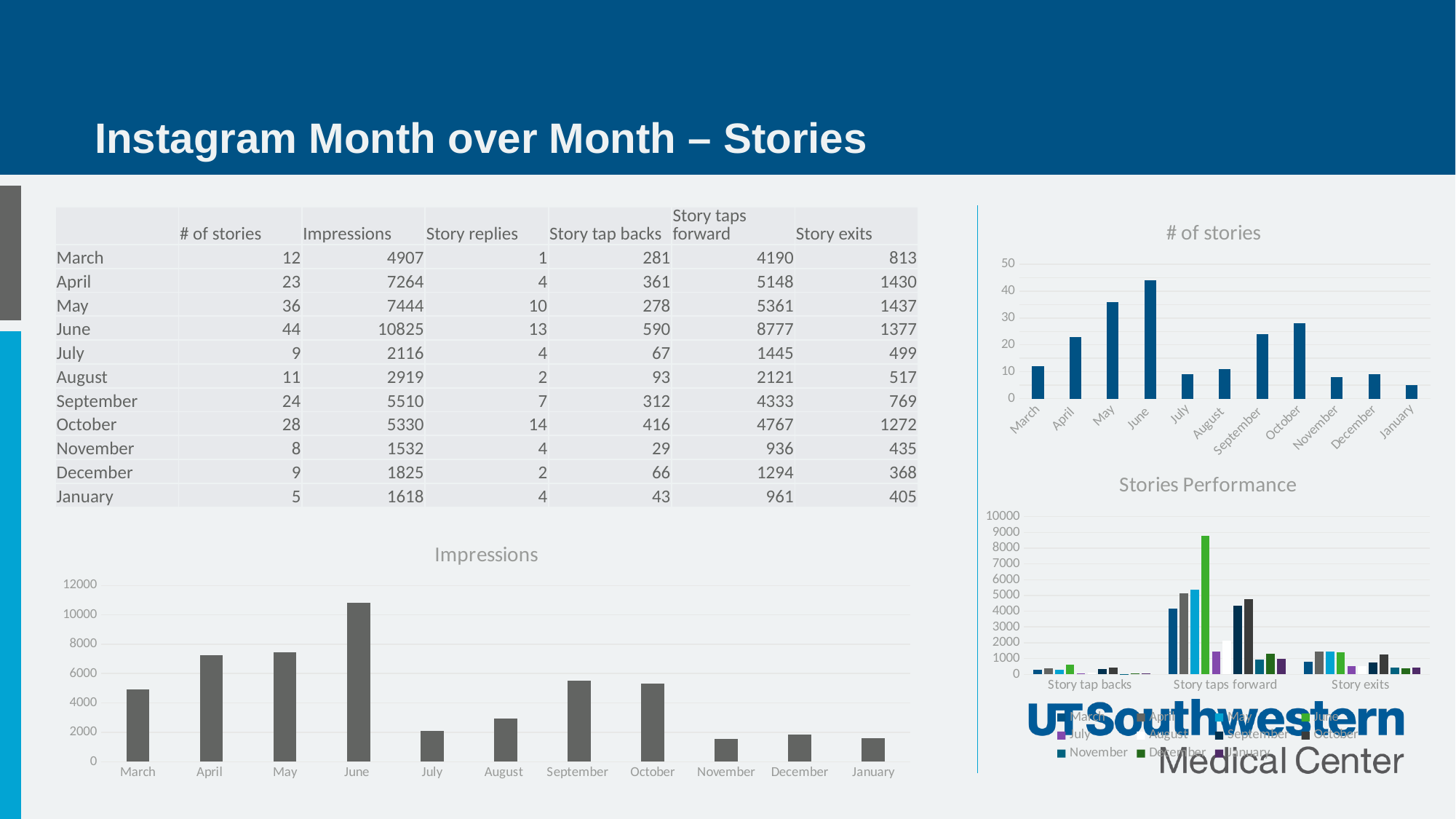
How many series does the legend of the Stories Performance chart list? 11 In the Impressions chart, which month has the highest value? June In the # of stories chart, which month has the lowest value? January In the Impressions chart, is the value for June greater or less than 10000? greater What kind of chart is the Impressions chart? bar chart What is the Impressions value for June? 10825 How many category groups are shown on the x axis of the Stories Performance chart? 3 How many months are shown on the x axis of the # of stories chart? 11 In the Impressions chart, which is larger, the value for April or the value for September? April In the Stories Performance chart, which category group contains the tallest bar? Story taps forward In the # of stories chart, is the value for May greater or less than 30? greater What is the difference between the # of stories for June and for March? 32